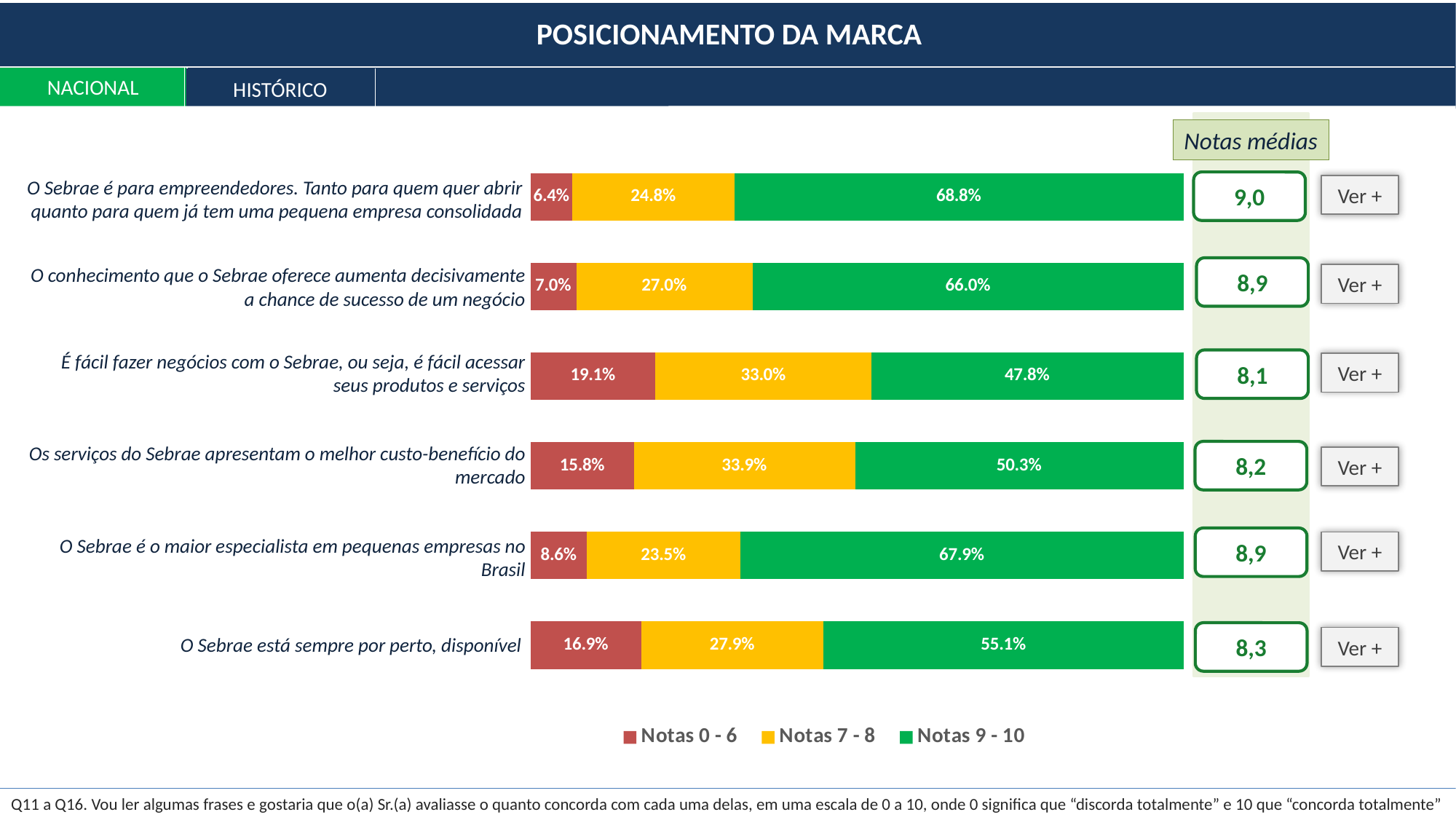
What percentage of respondents gave 'Notas 9 - 10' for the statement 'O Sebrae está sempre por perto, disponível'? 55.1% What is the 'Notas 7 - 8' share for the statement 'O Sebrae é o maior especialista em pequenas empresas no Brasil'? 23.5% What kind of chart is shown on the slide? Stacked bar chart How many statements are shown in the chart? 6 Which statement has the highest 'Notas 9 - 10' share? O Sebrae é para empreendedores. Tanto para quem quer abrir quanto para quem já tem uma pequena empresa consolidada Which statement has the lowest 'Notas 0 - 6' share? O Sebrae é para empreendedores. Tanto para quem quer abrir quanto para quem já tem uma pequena empresa consolidada What is the 'Nota média' shown for the statement 'É fácil fazer negócios com o Sebrae, ou seja, é fácil acessar seus produtos e serviços'? 8,1 What is the 'Notas 0 - 6' share for the statement 'É fácil fazer negócios com o Sebrae, ou seja, é fácil acessar seus produtos e serviços'? 19.1% What is the total of the stacked bar for 'O Sebrae é para empreendedores. Tanto para quem quer abrir quanto para quem já tem uma pequena empresa consolidada'? 100.0% How many series does the legend list? 3 What is the difference in 'Notas 7 - 8' share between 'Os serviços do Sebrae apresentam o melhor custo-benefício do mercado' and 'O Sebrae é o maior especialista em pequenas empresas no Brasil'? 10.4 percentage points Which has a larger 'Notas 9 - 10' share: 'O conhecimento que o Sebrae oferece aumenta decisivamente a chance de sucesso de um negócio' or 'O Sebrae está sempre por perto, disponível'? O conhecimento que o Sebrae oferece aumenta decisivamente a chance de sucesso de um negócio